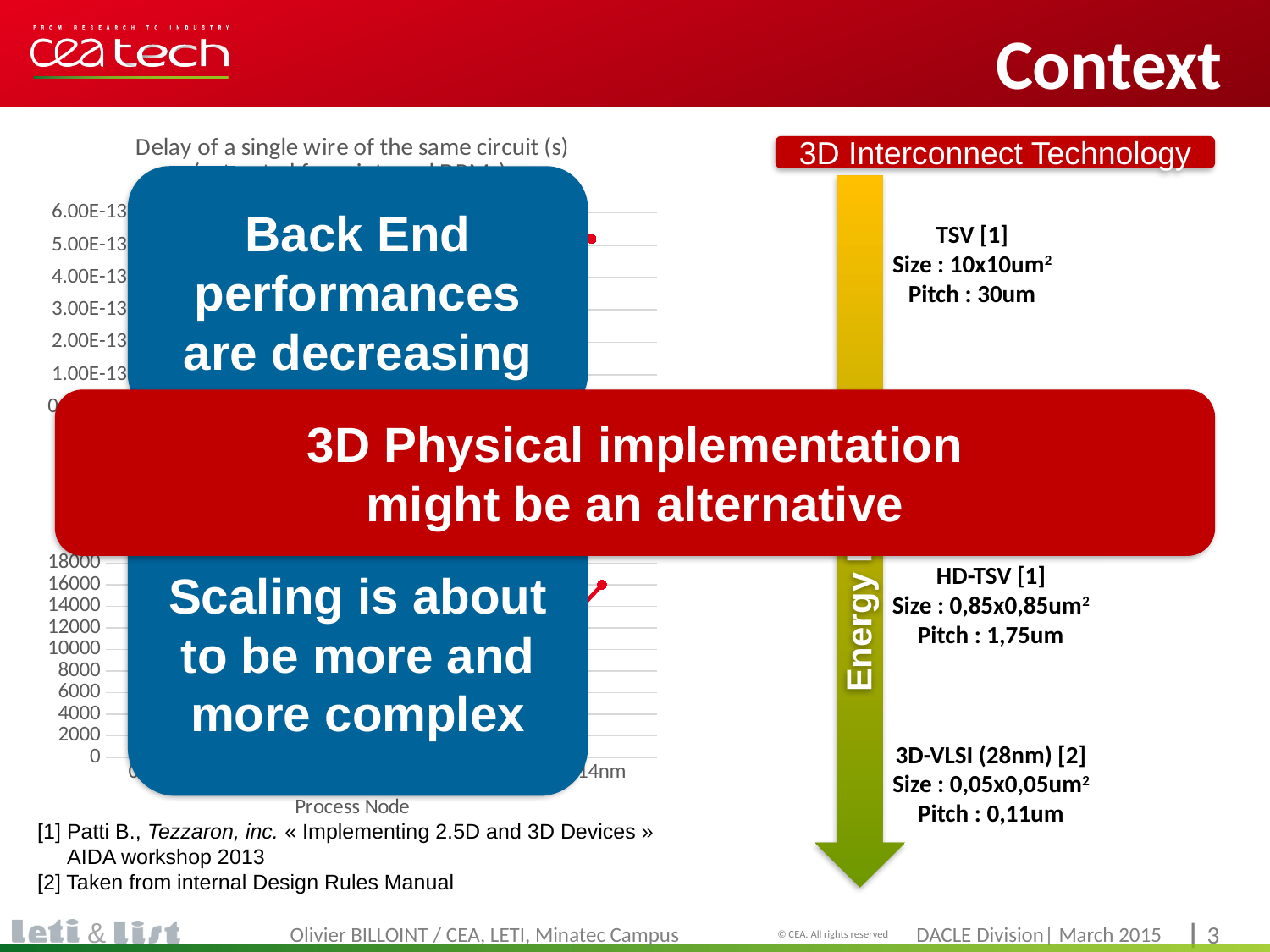
What kind of chart is the bottom chart on the slide? line chart What is the title of the top chart on the slide? Delay of a single wire of the same circuit (s) In the top chart, is the rightmost plotted point greater or less than 4.00E-13? greater In the bottom chart, does the line rise or fall as it approaches the 14nm point? rise In the bottom chart, is the value for 14nm greater or less than 12000? greater What is the x-axis title of the bottom chart on the slide? Process Node In the bottom chart, is the value for 14nm greater or less than 18000? less